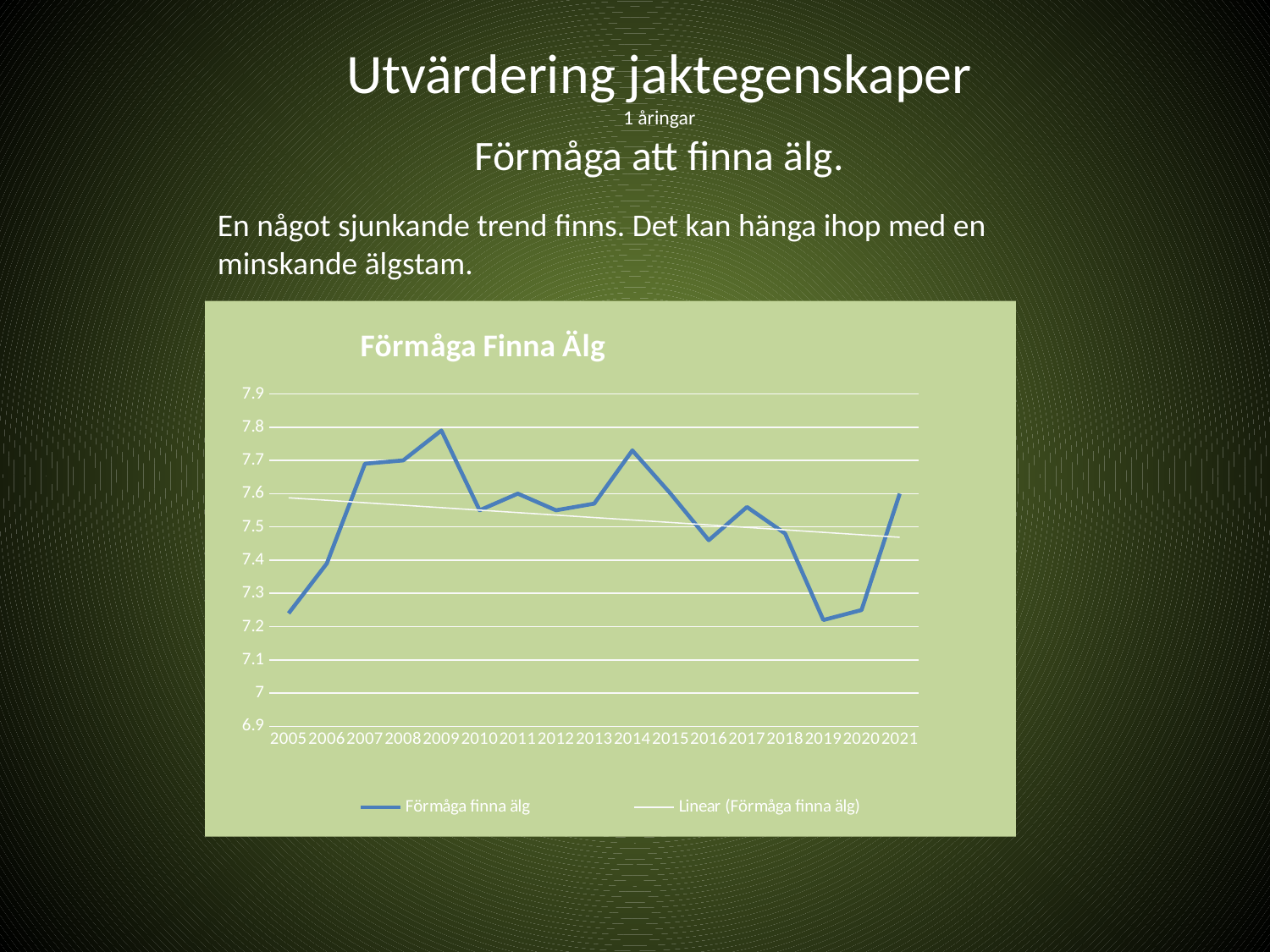
Which is larger, the value for 2006 or the value for 2007? 2007 How many series does the legend list? 2 Is the value for 2009 greater or less than 7.7? greater What kind of chart is shown on the slide? line chart Does the linear trend line rise or fall from 2005 to 2021? fall How many years are plotted along the x axis? 17 Is the value for 2016 greater or less than 7.5? less Which year has the highest value for Förmåga finna älg? 2009 Is the value for 2019 greater or less than 7.3? less Which is larger, the value for 2009 or the value for 2019? 2009 What is the title of the chart? Förmåga Finna Älg